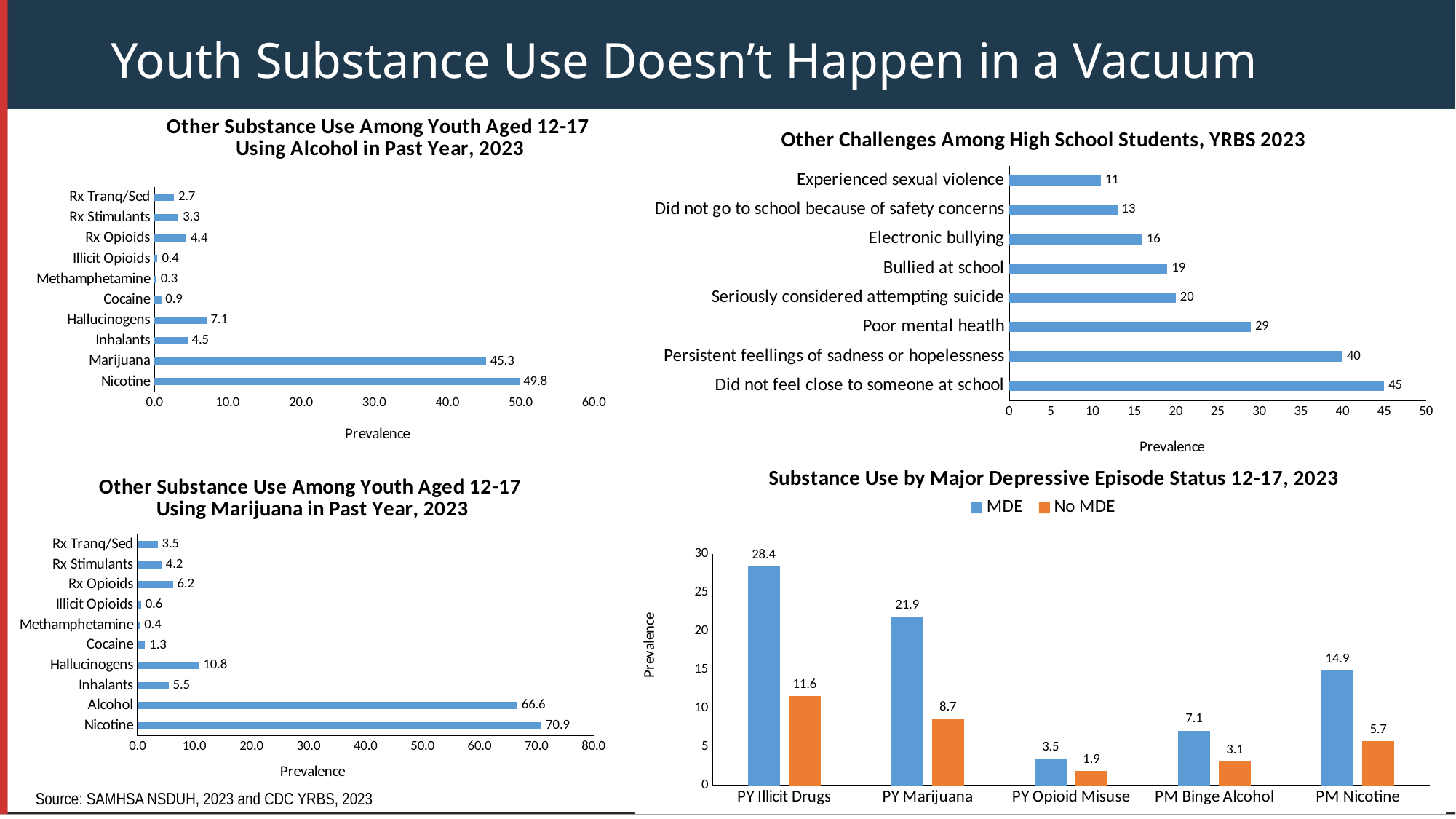
In the chart 'Substance Use by Major Depressive Episode Status 12-17, 2023', what is the MDE value for PY Marijuana? 21.9 In the chart 'Other Substance Use Among Youth Aged 12-17 Using Alcohol in Past Year, 2023', what is the value for Marijuana? 45.3 What type of chart is 'Substance Use by Major Depressive Episode Status 12-17, 2023'? Bar chart In the chart 'Other Substance Use Among Youth Aged 12-17 Using Marijuana in Past Year, 2023', which is larger, Alcohol or Nicotine? Nicotine How many series does the legend list in the chart 'Substance Use by Major Depressive Episode Status 12-17, 2023'? 2 In the chart 'Other Challenges Among High School Students, YRBS 2023', which category has the highest value? Did not feel close to someone at school In the chart 'Other Substance Use Among Youth Aged 12-17 Using Alcohol in Past Year, 2023', how many categories are shown? 10 In the chart 'Other Substance Use Among Youth Aged 12-17 Using Marijuana in Past Year, 2023', what is the value for Hallucinogens? 10.8 In the chart 'Other Challenges Among High School Students, YRBS 2023', what is the difference between 'Persistent feelings of sadness or hopelessness' and 'Experienced sexual violence'? 29 In the chart 'Substance Use by Major Depressive Episode Status 12-17, 2023', what is the difference between the MDE and No MDE values for PY Illicit Drugs? 16.8 In the chart 'Other Substance Use Among Youth Aged 12-17 Using Alcohol in Past Year, 2023', which category has the lowest value? Methamphetamine In the chart 'Other Challenges Among High School Students, YRBS 2023', what is the value for Poor mental health? 29